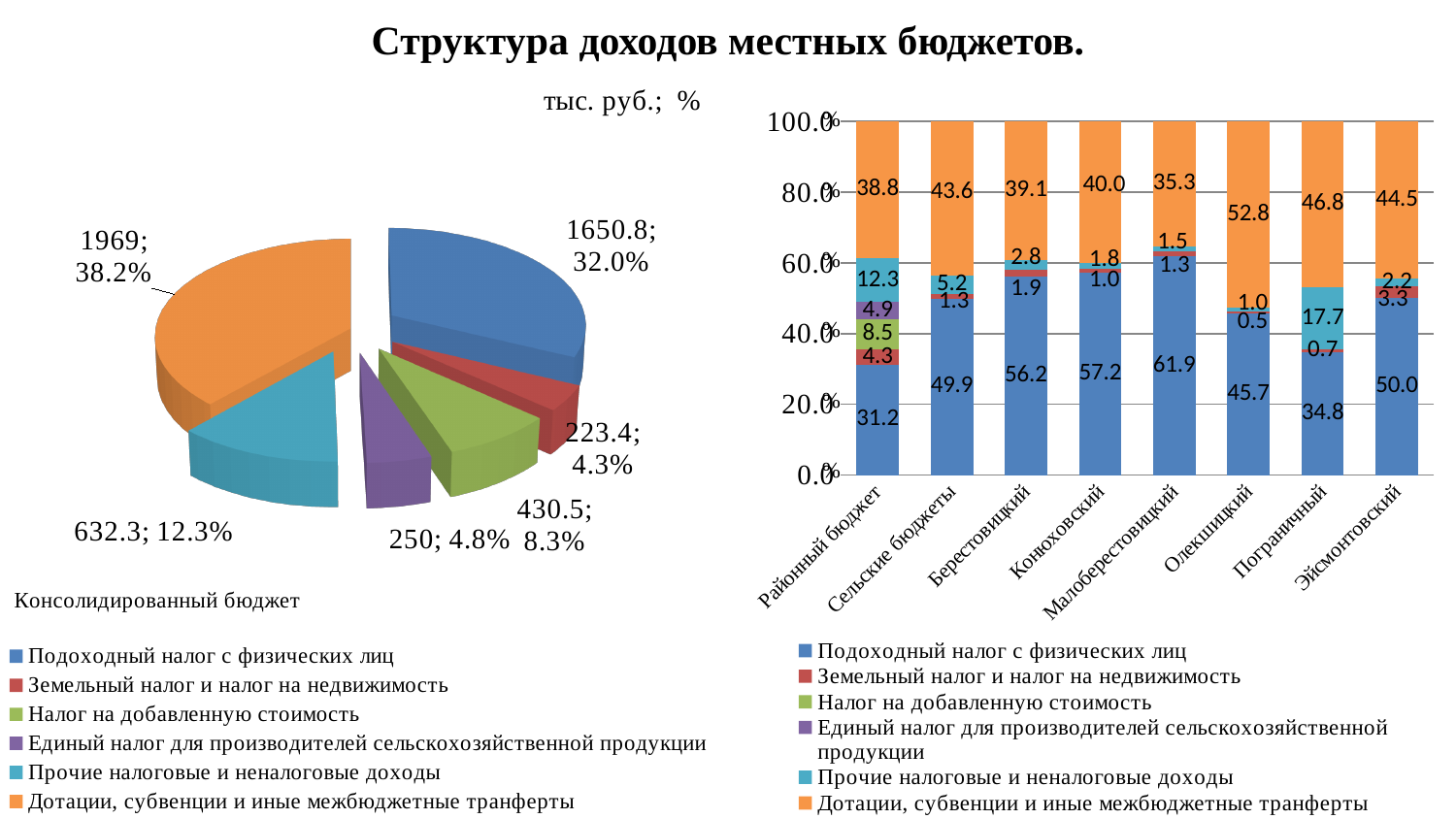
In the stacked bar chart on the right, what is the value of Подоходный налог с физических лиц for Малоберестовицкий? 61.9 In the stacked bar chart on the right, which is larger: Прочие налоговые и неналоговые доходы for Пограничный or for Районный бюджет? Пограничный In the stacked bar chart on the right, what is the value of Дотации, субвенции и иные межбюджетные трансферты for Олекшицкий? 52.8 In the stacked bar chart on the right, which category has the lowest value for Подоходный налог с физических лиц? Районный бюджет In the pie chart on the left, what is the difference between the values for Прочие налоговые и неналоговые доходы and Налог на добавленную стоимость? 201.8 In the pie chart on the left, which category has the smallest slice? Земельный налог и налог на недвижимость In the pie chart on the left, what share does Подоходный налог с физических лиц have? 32.0% What type of chart is shown on the right side of the slide? Stacked bar chart In the pie chart on the left (Консолидированный бюджет), what value and share are shown for Дотации, субвенции и иные межбюджетные трансферты? 1969; 38.2% In the stacked bar chart on the right, which category has the highest value for Подоходный налог с физических лиц? Малоберестовицкий In the stacked bar chart on the right, how many categories are shown on the x axis? 8 In the pie chart on the left, how many slices are there? 6